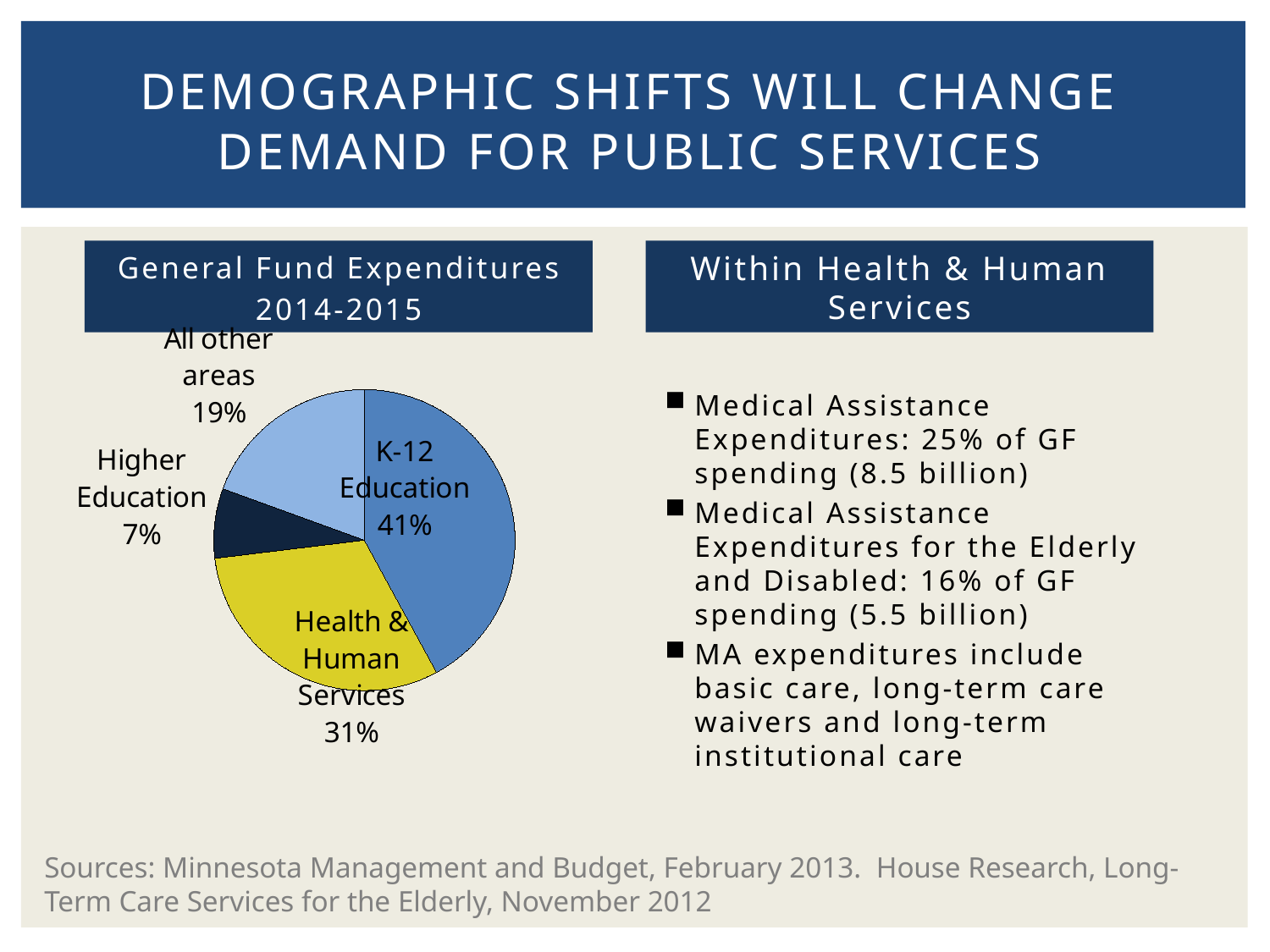
What is the title shown above the pie chart? General Fund Expenditures 2014-2015 What share of General Fund Expenditures 2014-2015 goes to K-12 Education? 41% Which category has the largest share of General Fund Expenditures 2014-2015? K-12 Education How many slices does the General Fund Expenditures 2014-2015 pie chart have? 4 What kind of chart is shown under the heading "General Fund Expenditures 2014-2015"? Pie chart What share of General Fund Expenditures 2014-2015 goes to Health & Human Services? 31% In the General Fund Expenditures 2014-2015 pie chart, what is the combined share of K-12 Education and Higher Education? 48% In the General Fund Expenditures 2014-2015 pie chart, what is the difference in percentage points between K-12 Education and Health & Human Services? 10 percentage points Which category has the smallest share of General Fund Expenditures 2014-2015? Higher Education What share of General Fund Expenditures 2014-2015 goes to Higher Education? 7% In the General Fund Expenditures 2014-2015 pie chart, which is larger: All other areas or Higher Education? All other areas What share of General Fund Expenditures 2014-2015 goes to All other areas? 19%